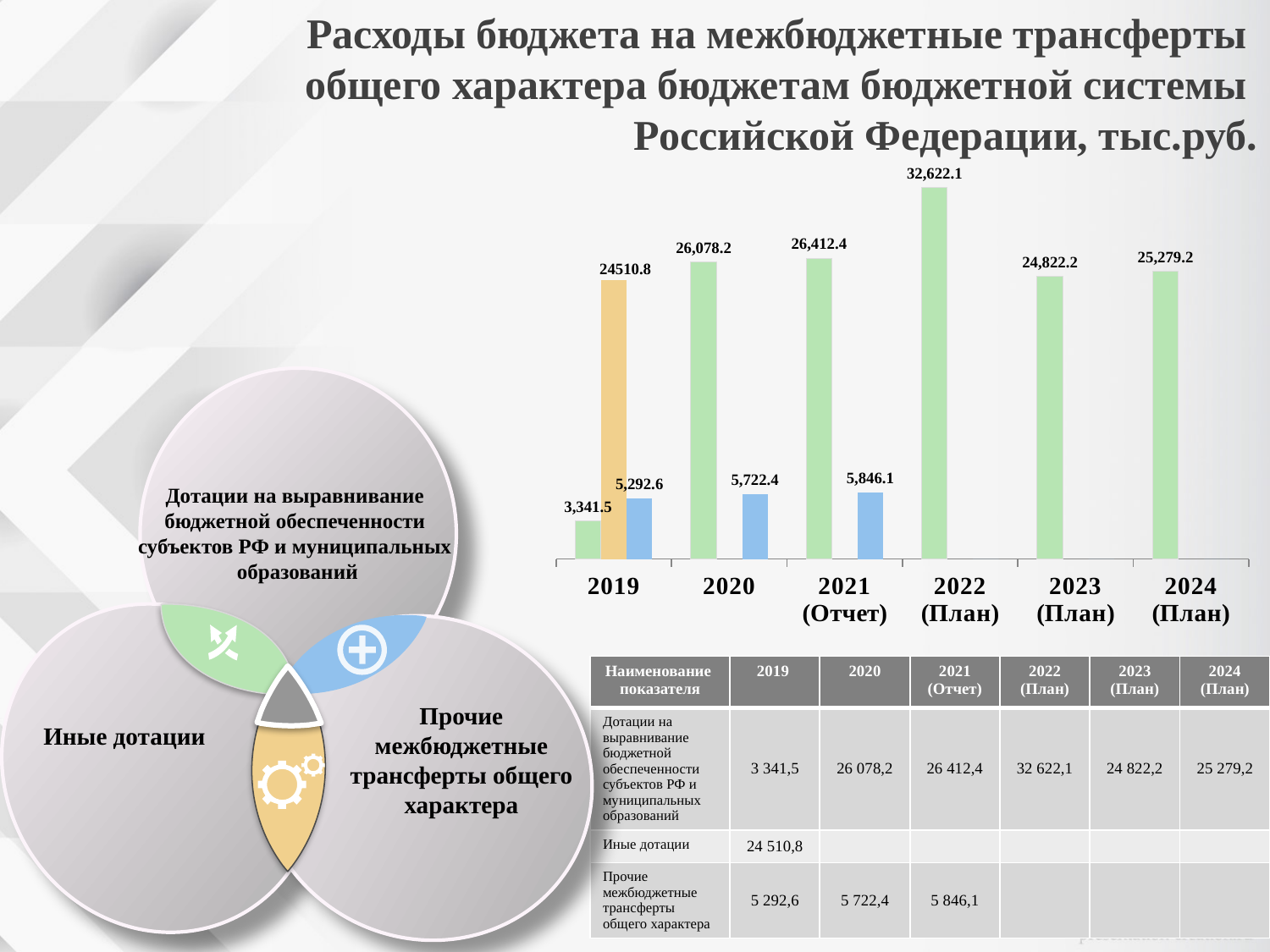
What kind of chart is shown on the slide? bar chart What is the value of the green bar for 2022 (План)? 32,622.1 What is the difference between the green bar values for 2021 (Отчет) and 2020? 334.2 Does the green bar value rise or fall from 2022 (План) to 2023 (План)? fall How many year categories are shown on the x axis of the chart? 6 Which green bar is larger, 2023 (План) or 2024 (План)? 2024 (План) In which year is the green bar the lowest? 2019 What is the value of the blue bar for 2021 (Отчет)? 5,846.1 What is the difference between the blue bar values for 2021 (Отчет) and 2019? 553.5 In which year is the green bar the highest? 2022 (План) How many bars are plotted for 2019? 3 What is the value of the orange bar in 2019? 24510.8